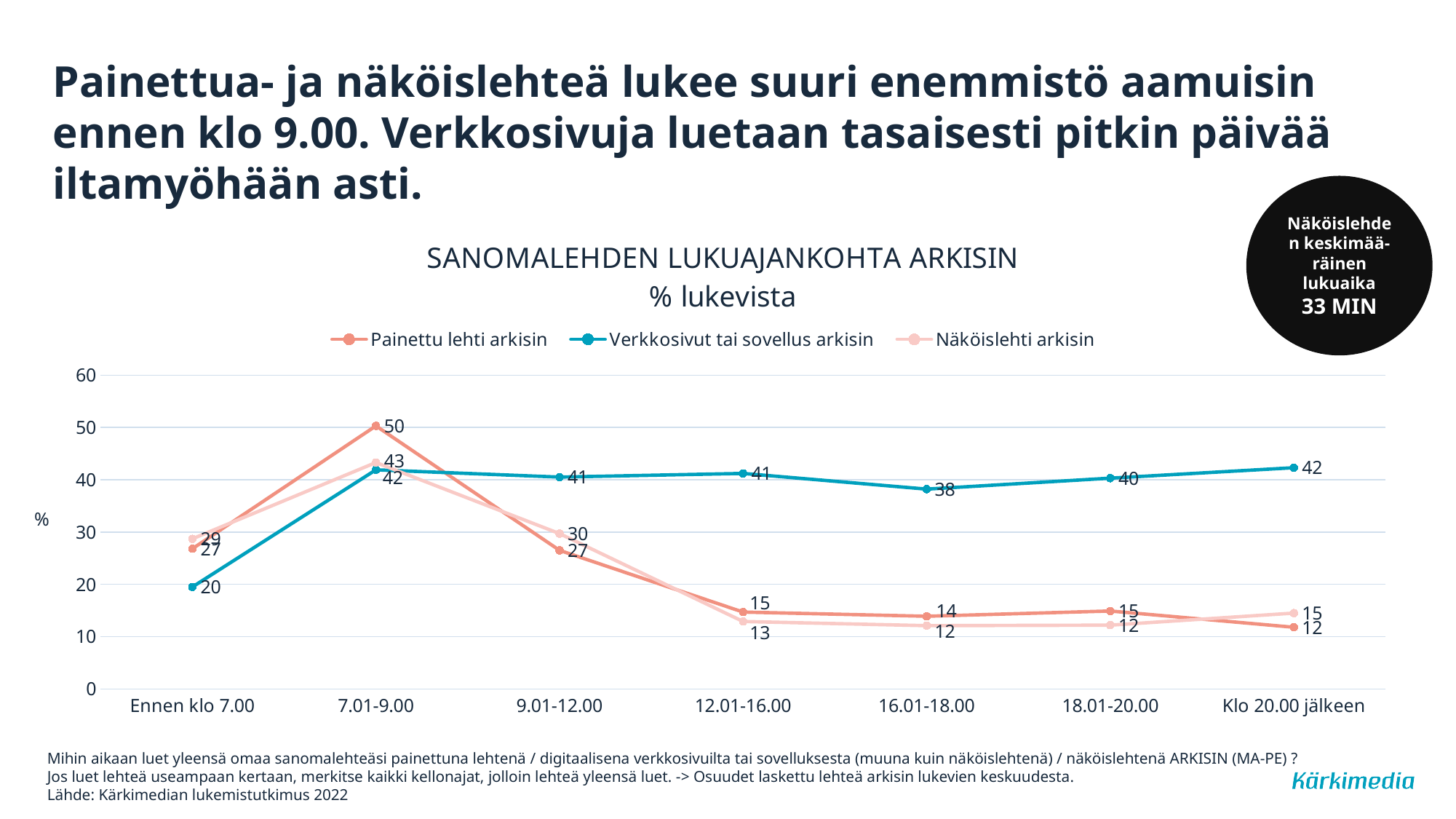
Does the Painettu lehti arkisin series rise or fall from 7.01-9.00 to 12.01-16.00? fall How many series does the legend list? 3 Is the value for Verkkosivut tai sovellus arkisin at Klo 20.00 jälkeen greater or less than 40? greater How many time slots are shown on the x axis? 7 At 9.01-12.00, which is larger: Verkkosivut tai sovellus arkisin or Painettu lehti arkisin? Verkkosivut tai sovellus arkisin In which time slot is the Verkkosivut tai sovellus arkisin series lowest? Ennen klo 7.00 What is the difference between Painettu lehti arkisin and Verkkosivut tai sovellus arkisin at 7.01-9.00? 8 What is the value for Verkkosivut tai sovellus arkisin at 16.01-18.00? 38 What is the value for Painettu lehti arkisin at 7.01-9.00? 50 What kind of chart is shown on the slide? line chart In which time slot is the Painettu lehti arkisin series highest? 7.01-9.00 What is the value for Näköislehti arkisin at Ennen klo 7.00? 29